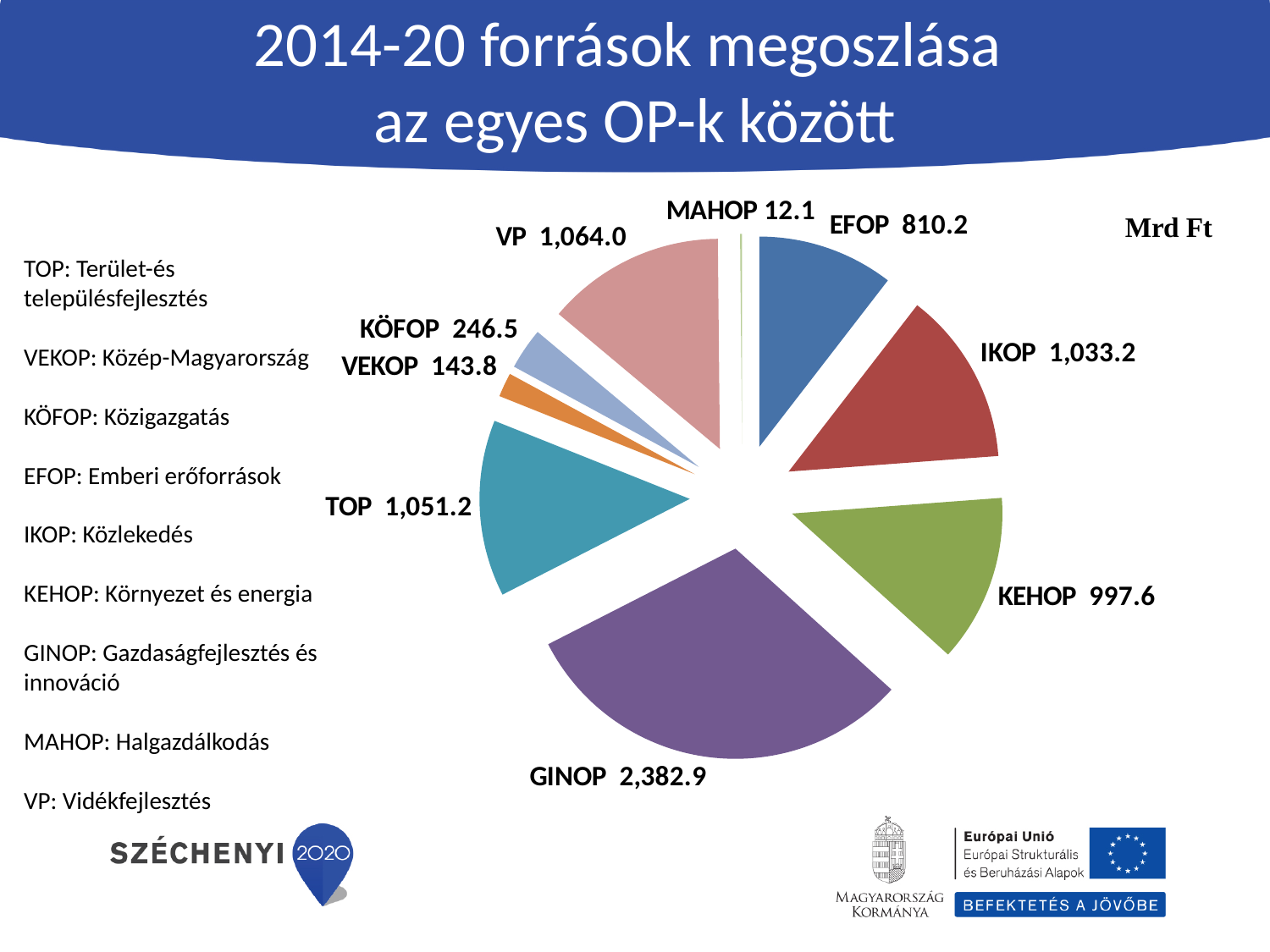
Which is larger, the value for IKOP or the value for EFOP? IKOP How many slices does the pie chart have? 9 What is the difference between the values for KÖFOP and VEKOP? 102.7 What is the value shown for KEHOP? 997.6 What is the value shown for MAHOP? 12.1 What is the value shown for VEKOP? 143.8 Which operational programme has the smallest slice of the pie? MAHOP What kind of chart is shown on the slide? pie chart Which operational programme has the largest slice of the pie? GINOP What is the value shown for GINOP? 2,382.9 What is the difference between the values for GINOP and TOP? 1,331.7 What unit is indicated for the values in the pie chart? Mrd Ft